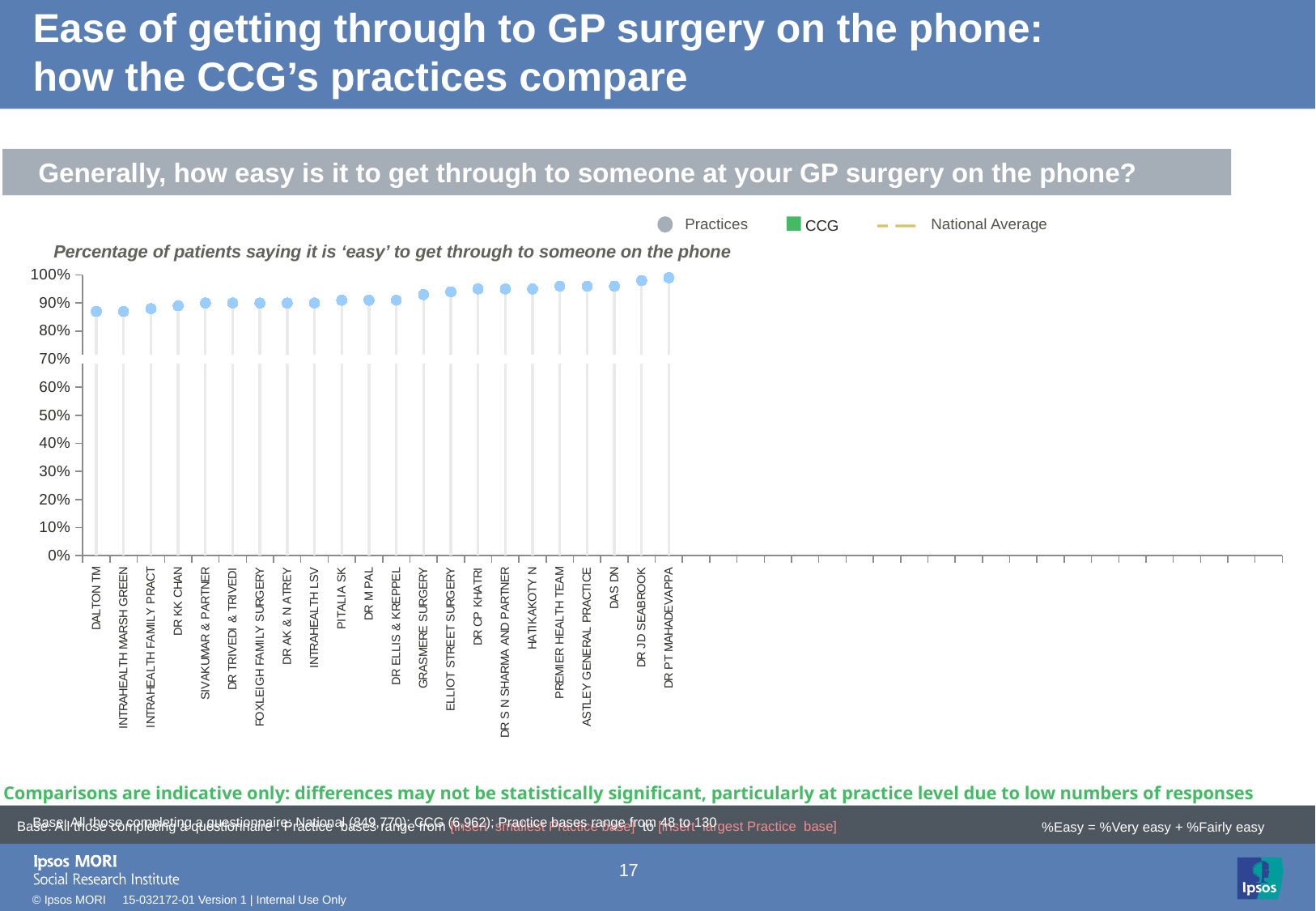
What are the three entries in the chart legend? Practices, CCG, National Average Is the value for ELLIOT STREET SURGERY greater or less than 90%? greater How many series does the chart legend list? 3 Is the value for DR PT MAHADEVAPPA greater or less than 90%? greater Is the value for INTRAHEALTH MARSH GREEN greater or less than 90%? less Which has the larger value, DR CP KHATRI or INTRAHEALTH MARSH GREEN? DR CP KHATRI Which has the larger value, DR PT MAHADEVAPPA or DALTON TM? DR PT MAHADEVAPPA What is the highest value shown on the chart's vertical axis? 100% How many practices are plotted on the chart? 22 Do the plotted values rise or fall from left to right along the x axis? rise